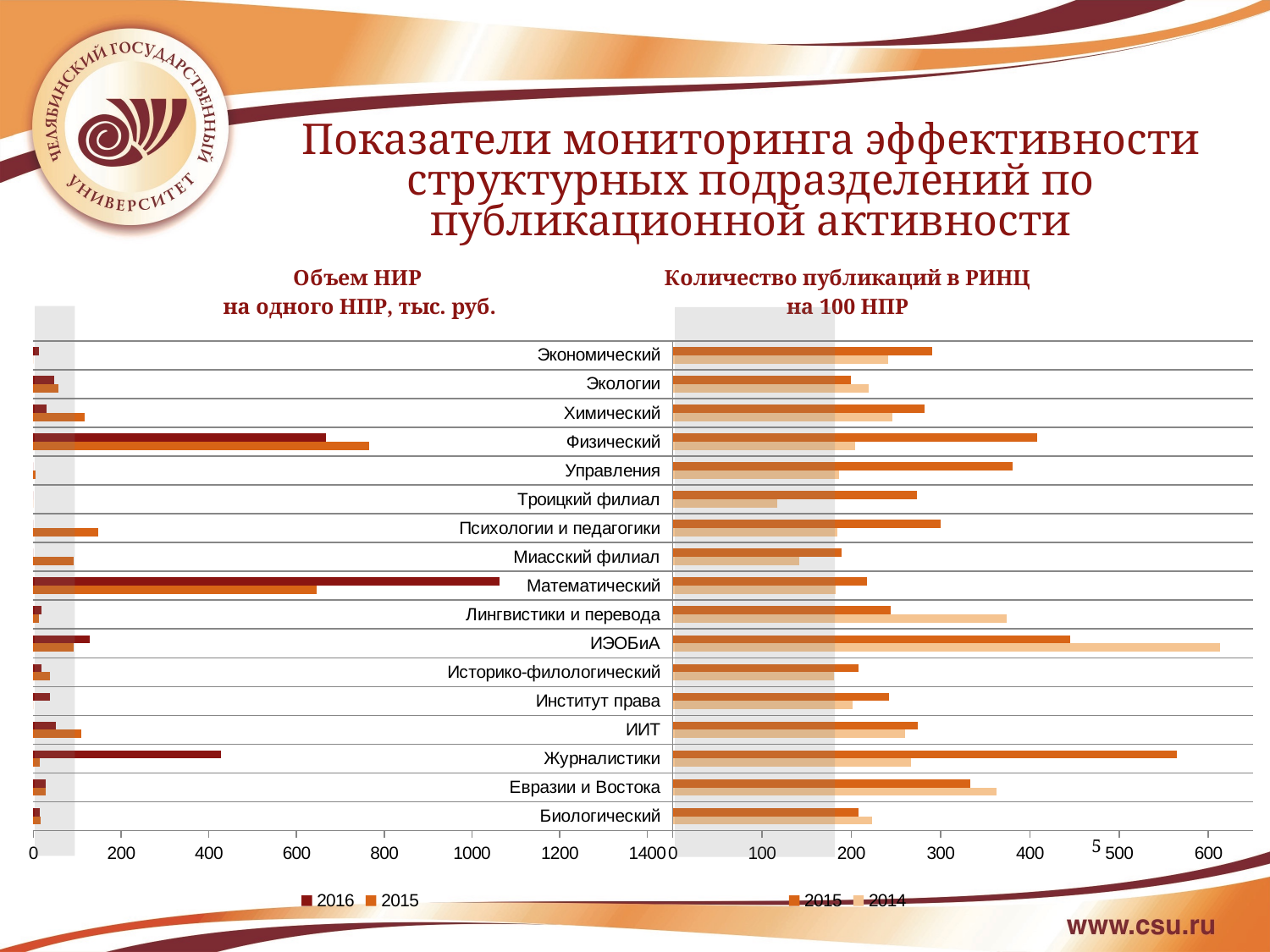
How many departments (categories) are listed on the right chart, "Количество публикаций в РИНЦ на 100 НПР"? 17 On the left chart, "Объем НИР на одного НПР, тыс. руб.", which department has the highest 2015 value? Физический What kind of chart is the left chart, "Объем НИР на одного НПР, тыс. руб."? bar chart On the right chart, "Количество публикаций в РИНЦ на 100 НПР", is the 2014 value for ИЭОБиА greater or less than 500? greater On the left chart, "Объем НИР на одного НПР, тыс. руб.", is the 2016 value for Журналистики greater or less than 600? less How many series does the legend of the left chart, "Объем НИР на одного НПР, тыс. руб.", list? 2 On the left chart, "Объем НИР на одного НПР, тыс. руб.", which department has the highest 2016 value? Математический On the left chart, "Объем НИР на одного НПР, тыс. руб.", is the 2016 value for Математический greater or less than 800? greater On the right chart, "Количество публикаций в РИНЦ на 100 НПР", which department has the highest 2015 value? Журналистики On the right chart, "Количество публикаций в РИНЦ на 100 НПР", which department has the lowest 2014 value? Троицкий филиал Which years are listed in the legend of the right chart, "Количество публикаций в РИНЦ на 100 НПР"? 2015 and 2014 On the right chart, "Количество публикаций в РИНЦ на 100 НПР", which is larger for Лингвистики и перевода: the 2015 value or the 2014 value? 2014